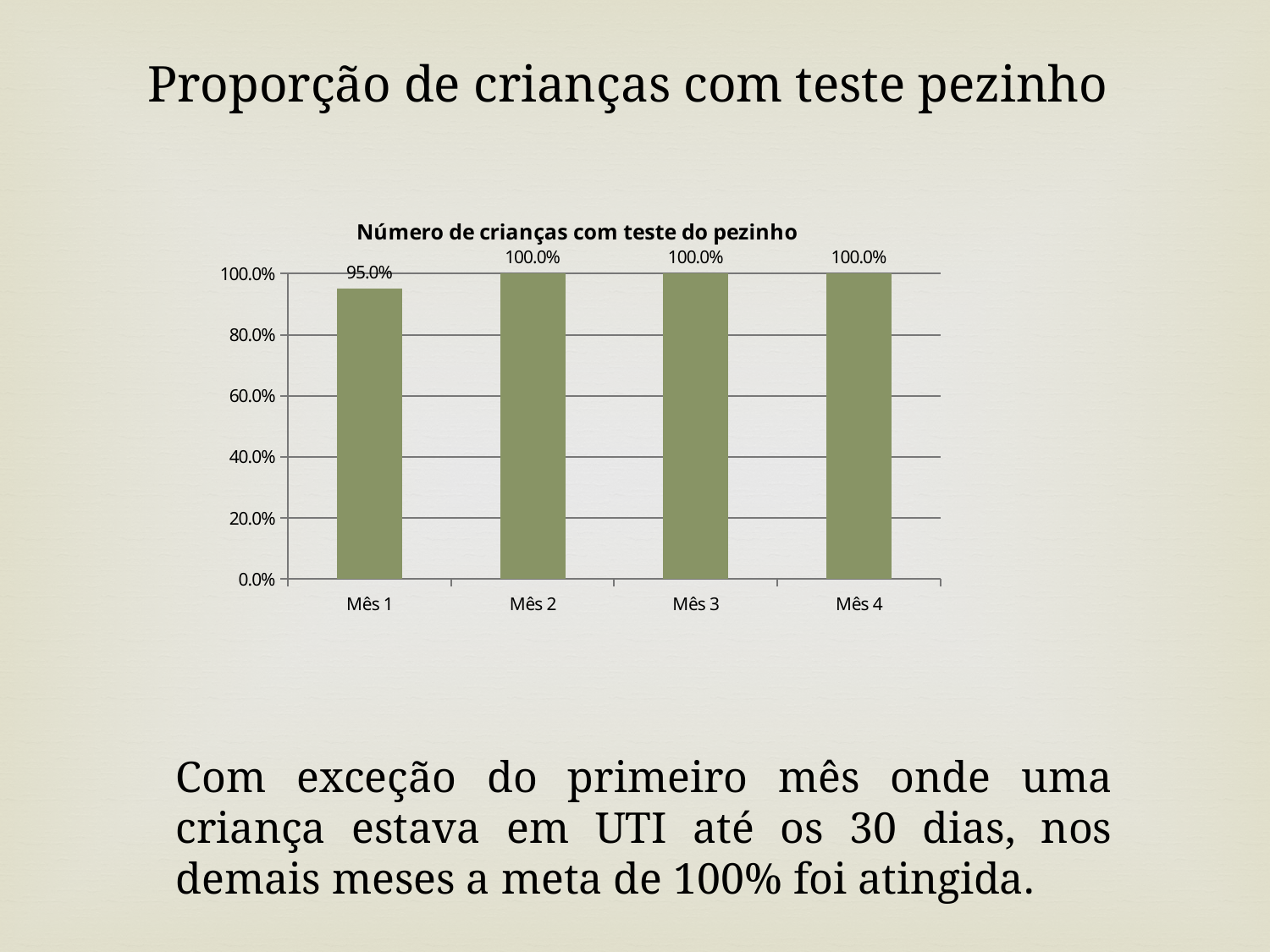
Do the values rise or fall from Mês 1 to Mês 2? rise What kind of chart is shown? bar chart What is the value for Mês 1? 95.0% Is the value for Mês 1 greater or less than 80.0%? greater What is the title of the chart? Número de crianças com teste do pezinho What is the value for Mês 4? 100.0% How many months are shown on the x axis? 4 What is the value for Mês 3? 100.0% Which month has the lowest value? Mês 1 How many months reach 100.0%? 3 What is the difference between the values for Mês 2 and Mês 1? 5.0% Which is larger, the value for Mês 1 or the value for Mês 4? Mês 4